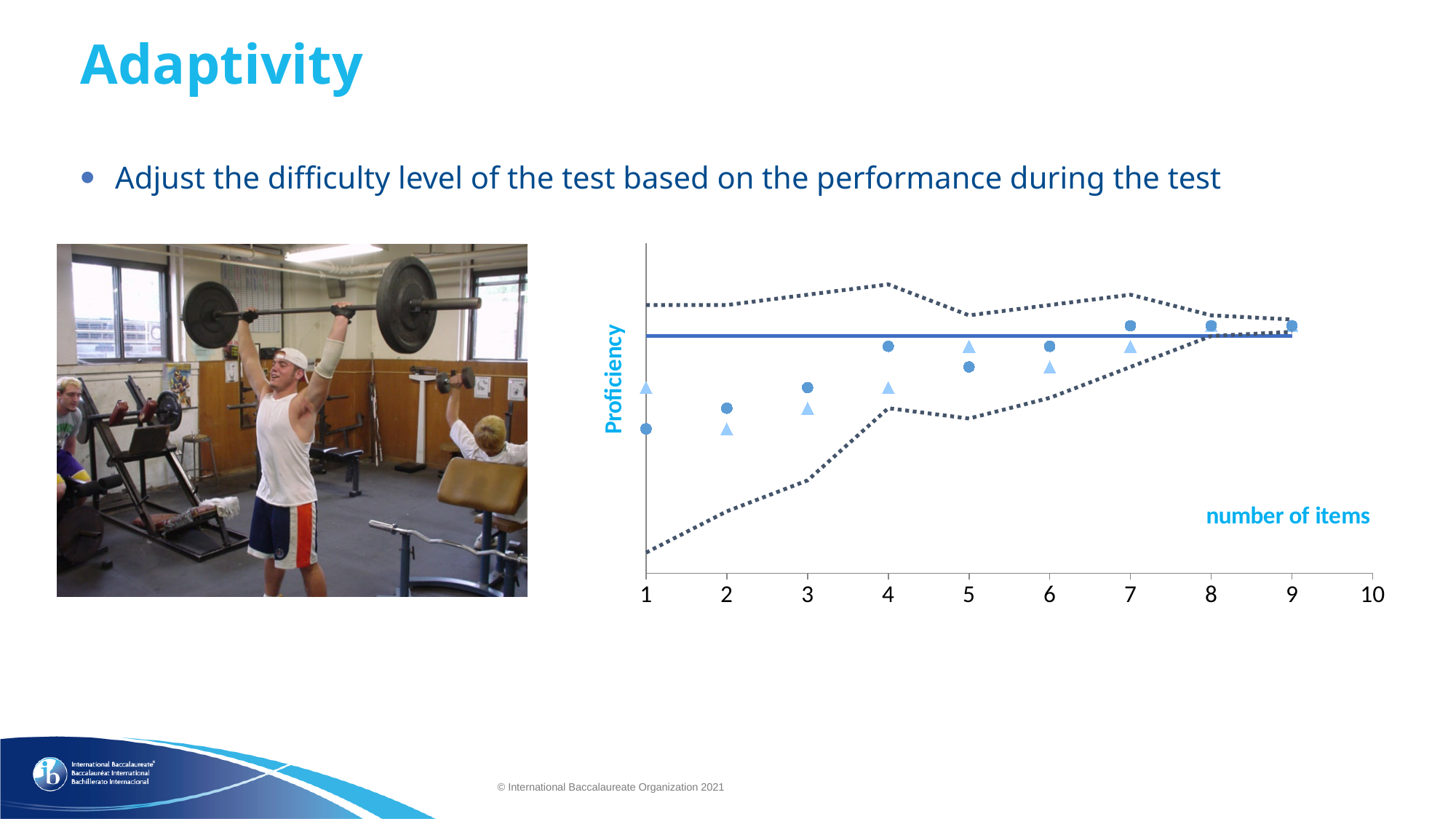
At which number of items is the circle marker lowest? 1 At number of items 1, which marker is higher, the circle or the triangle? triangle Do the circle markers generally rise or fall as the number of items increases? rise At number of items 5, which marker is higher, the circle or the triangle? triangle What is the label of the y axis of the chart? Proficiency What kind of chart is shown on the slide? scatter chart At number of items 2, which marker is higher, the circle or the triangle? circle At which number of items is the triangle marker lowest? 2 How many circle markers are plotted on the chart? 9 How many tick labels are shown on the x axis of the chart? 10 What is the label of the x axis of the chart? number of items